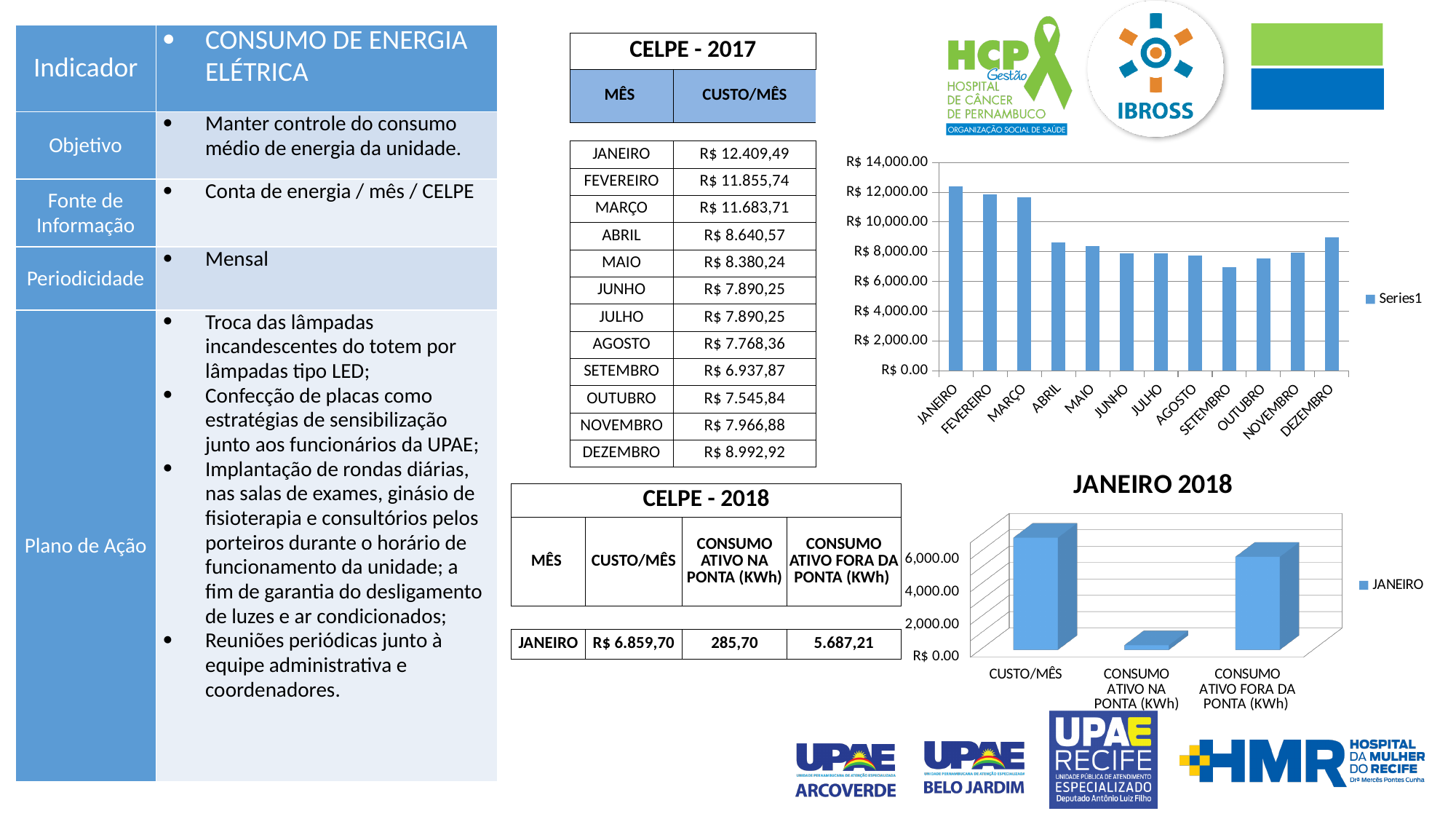
In the bar chart at the top right, is the value for ABRIL greater or less than R$ 8,000.00? greater In the bar chart at the top right, how many months are plotted along the x axis? 12 In the bar chart at the top right, do the values rise or fall from JANEIRO to SETEMBRO? fall In the JANEIRO 2018 chart, which category has the lowest value? CONSUMO ATIVO NA PONTA (KWh) In the JANEIRO 2018 chart, is the value for CUSTO/MÊS greater or less than 6,000.00? greater What type of chart is shown at the top right of the slide? bar chart In the bar chart at the top right, which month has the lowest value? SETEMBRO What is the name of the series listed in the legend of the bar chart at the top right? Series1 In the JANEIRO 2018 chart, how many categories are shown on the x axis? 3 In the bar chart at the top right, is the value for SETEMBRO greater or less than R$ 8,000.00? less In the bar chart at the top right, which month has the highest value? JANEIRO In the bar chart at the top right, which is larger, the value for MARÇO or the value for ABRIL? MARÇO